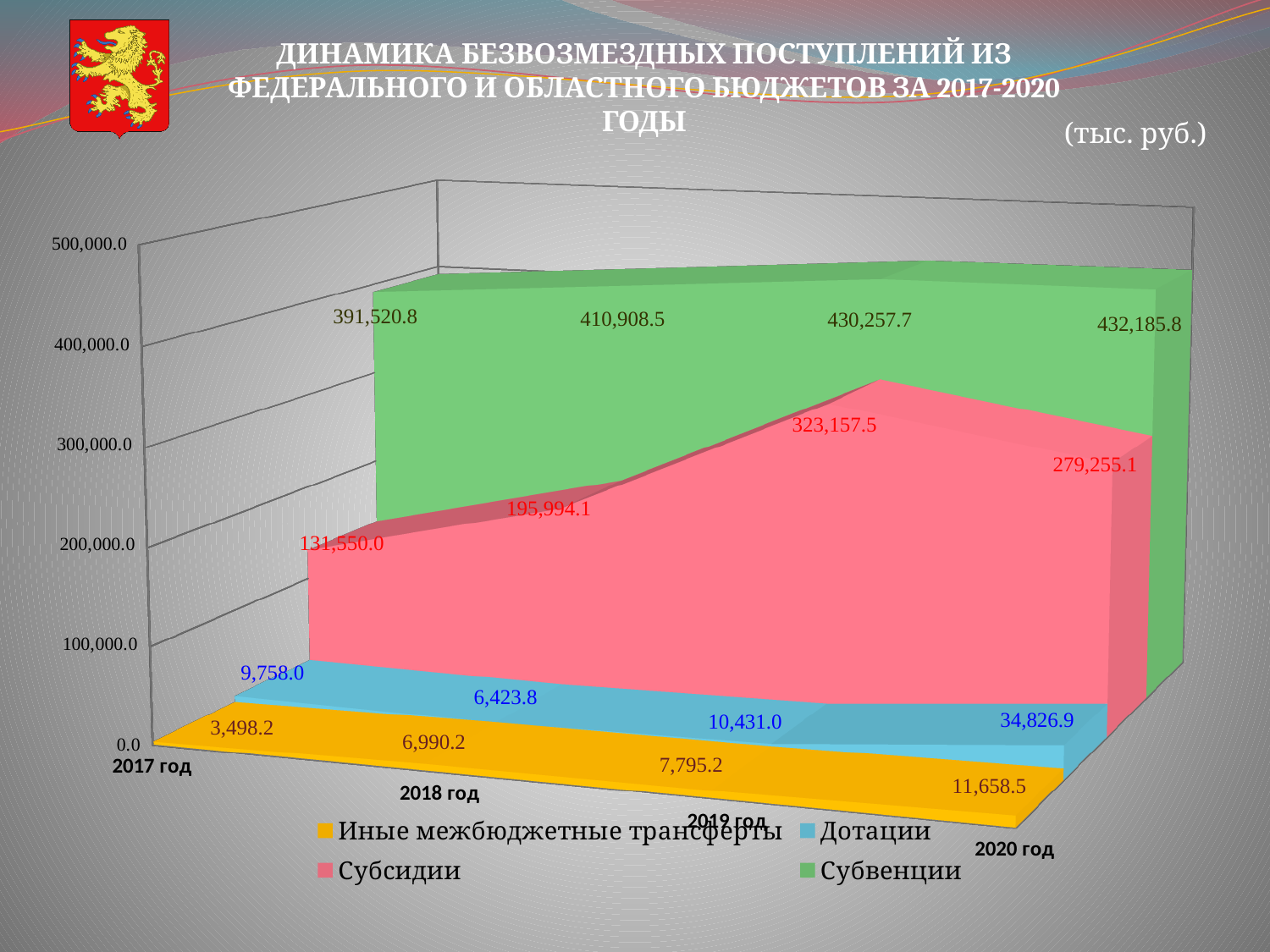
Do the values of Иные межбюджетные трансферты rise or fall from 2017 год to 2020 год? Rise What is the value of Субсидии for 2018 год? 195,994.1 How many series does the legend list? 4 How many years are shown on the x axis? 4 What is the value of Дотации for 2020 год? 34,826.9 What is the value of Субвенции for 2019 год? 430,257.7 Which is larger: Субсидии in 2019 год or Субсидии in 2020 год? Субсидии in 2019 год What kind of chart is shown on the slide? Area chart What is the difference between the Субвенции values for 2020 год and 2017 год? 40,665.0 What is the value of Иные межбюджетные трансферты for 2017 год? 3,498.2 In which year is the value of Дотации lowest? 2018 год In which year is the value of Субсидии highest? 2019 год